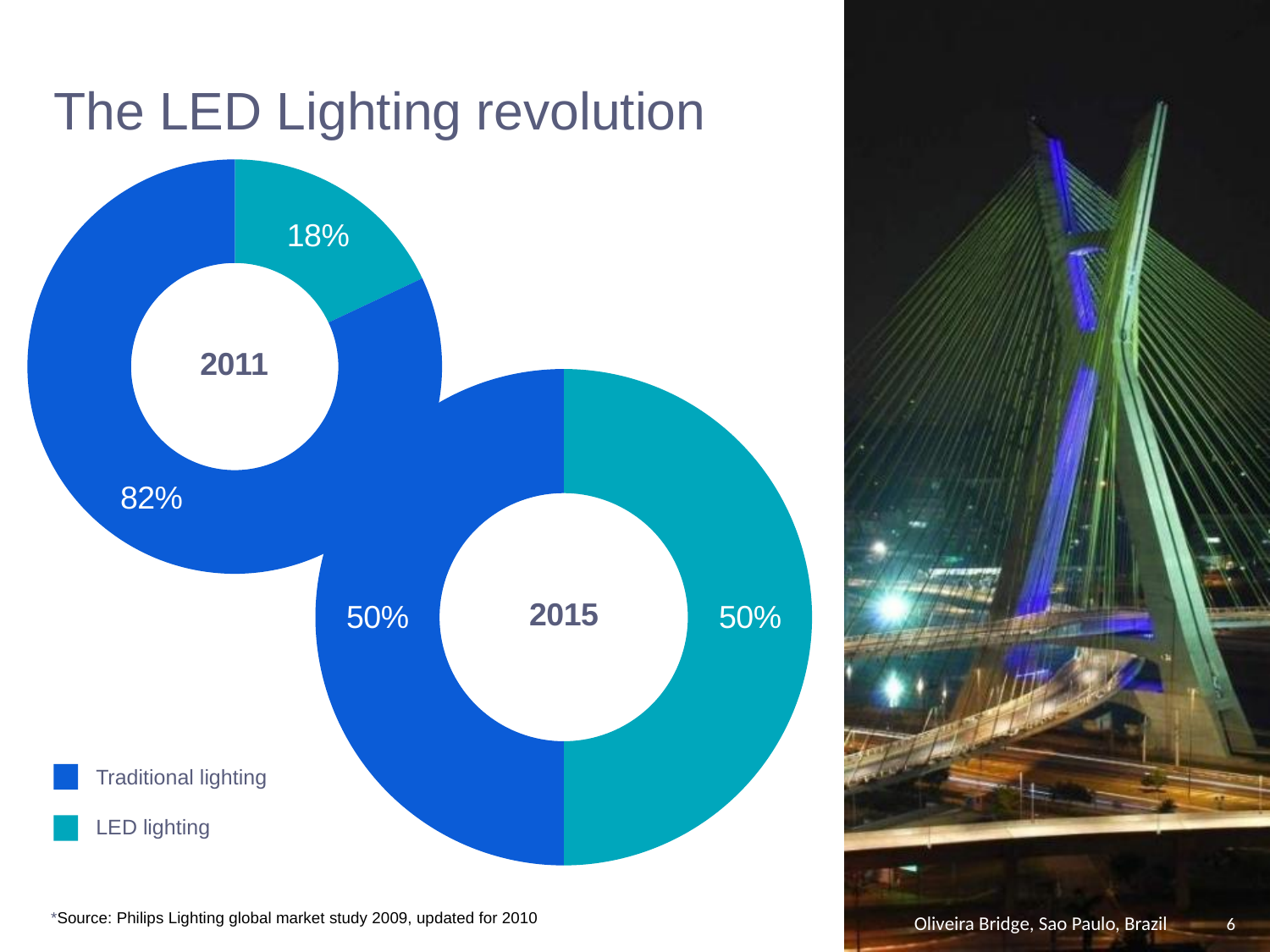
In the 2011 chart, what is the difference between the Traditional lighting share and the LED lighting share? 64 percentage points In the 2011 chart, which category has the smallest share? LED lighting In the 2015 chart, what share is LED lighting? 50% In the 2011 chart, which category has the largest share? Traditional lighting In the 2011 chart, what share is LED lighting? 18% How many doughnut charts are shown on the slide? 2 In the 2015 chart, what share is Traditional lighting? 50% What is the title of the slide containing the charts? The LED Lighting revolution In the 2011 chart, is the share for Traditional lighting larger or smaller than the share for LED lighting? larger How many categories does the legend list? 2 In the 2011 chart, what share is Traditional lighting? 82% What kind of chart is used to show the 2011 and 2015 data? Doughnut (pie) chart